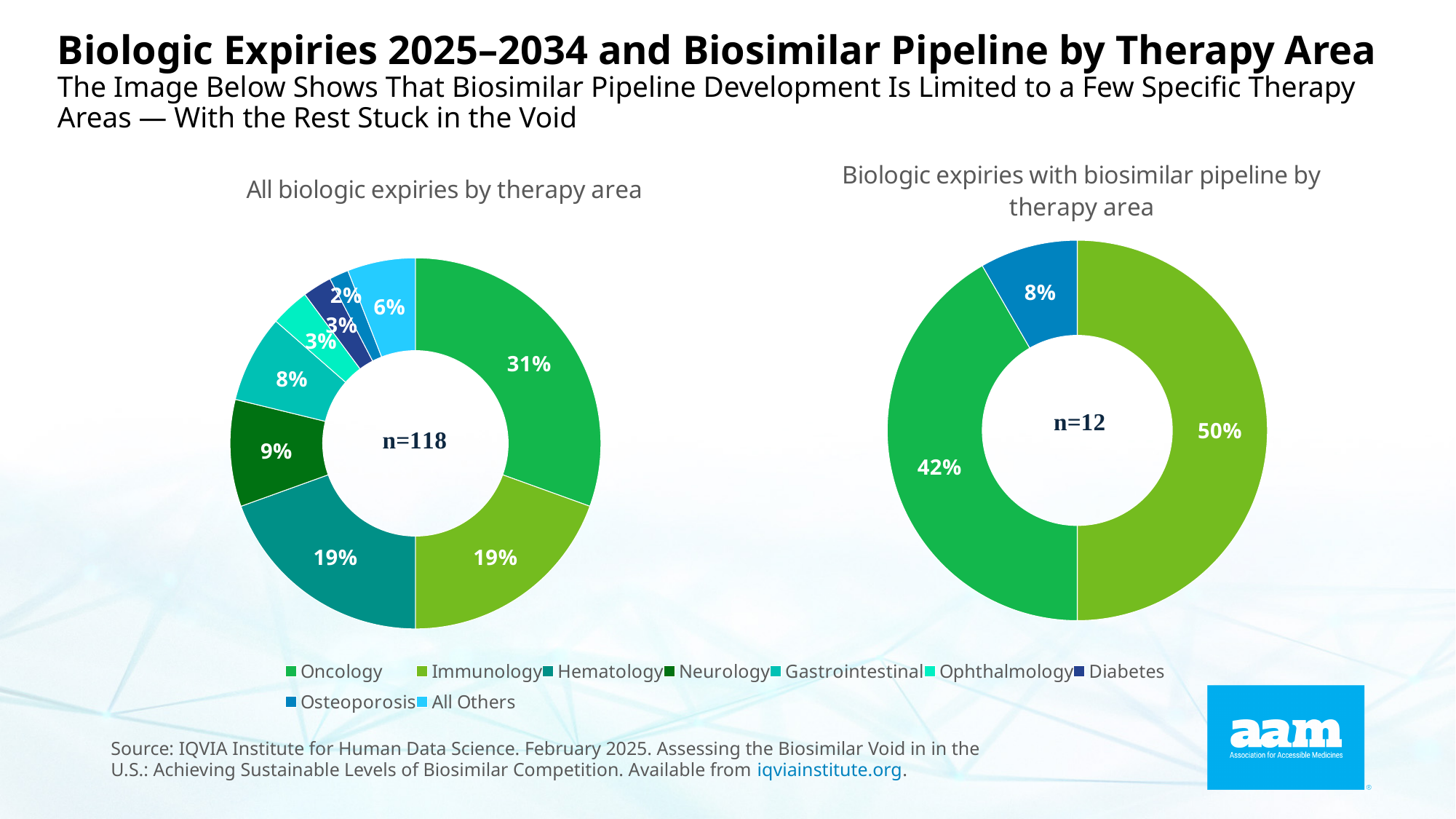
In the chart titled "All biologic expiries by therapy area", what share does Oncology have? 31% What kind of chart is used for "All biologic expiries by therapy area"? Donut (pie) chart In the chart titled "Biologic expiries with biosimilar pipeline by therapy area", which therapy area has the smallest share? Osteoporosis In the chart titled "All biologic expiries by therapy area", what share does Neurology have? 9% In the chart titled "Biologic expiries with biosimilar pipeline by therapy area", which is larger, the Immunology share or the Oncology share? Immunology In the chart titled "All biologic expiries by therapy area", what share does Gastrointestinal have? 8% In the chart titled "All biologic expiries by therapy area", what is the difference between the Oncology share and the Hematology share? 12% In the chart titled "All biologic expiries by therapy area", what is the n value shown in the centre of the donut? n=118 In the chart titled "All biologic expiries by therapy area", which therapy area has the largest share? Oncology In the chart titled "Biologic expiries with biosimilar pipeline by therapy area", what share does Immunology have? 50% In the chart titled "Biologic expiries with biosimilar pipeline by therapy area", what share does Oncology have? 42% In the chart titled "Biologic expiries with biosimilar pipeline by therapy area", how many slices does the donut have? 3